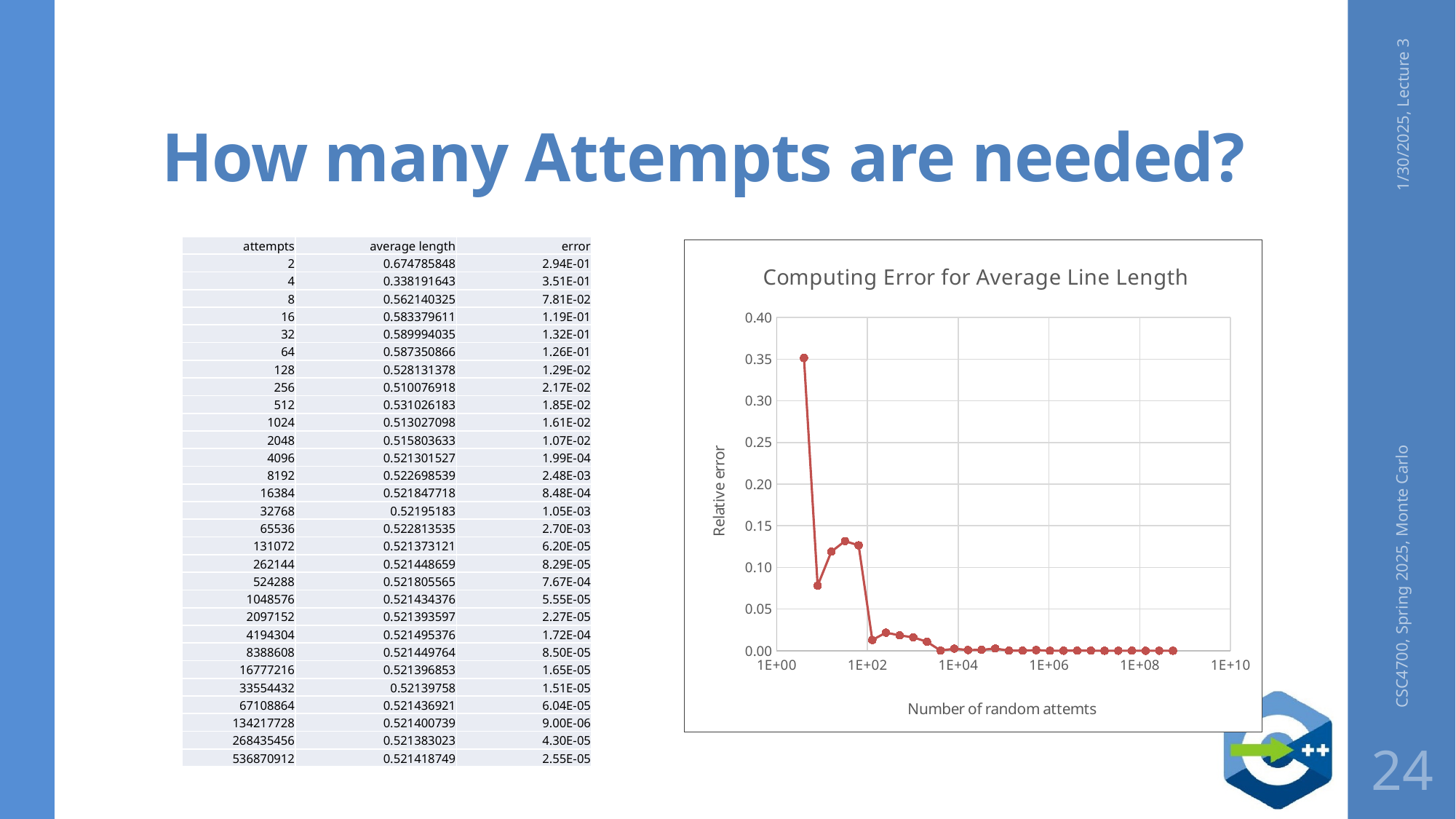
How many data series are plotted in the chart? 1 Is the relative error at 1E+06 random attempts greater or less than 0.05? less Is the relative error at the leftmost point of the chart greater or less than 0.30? greater What is the label on the y axis of the chart? Relative error Which has the larger relative error: the leftmost point or the rightmost point of the chart? the leftmost point According to the table on the slide, what is the average length for 536870912 attempts? 0.521418749 Overall, does the relative error rise or fall as the number of random attempts increases? fall What kind of chart is shown on the slide? line chart Where does the highest relative error occur in the chart? at the leftmost point (smallest number of attempts) According to the table on the slide, what is the error for 4096 attempts? 1.99E-04 What is the title of the chart? Computing Error for Average Line Length